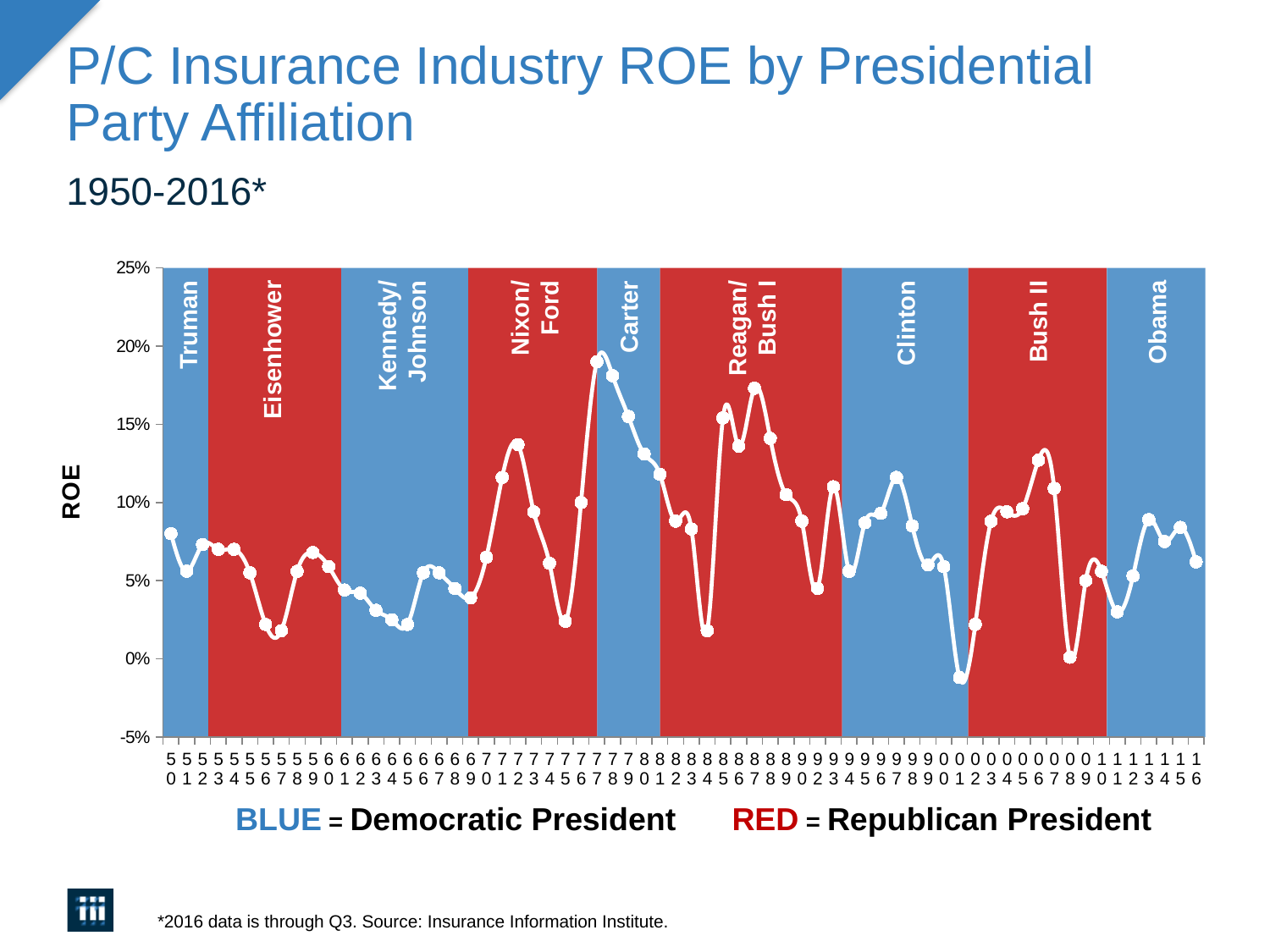
According to the legend below the chart, what does a red background represent? Republican President Does the ROE rise or fall from 1950 to 1956? fall Is the ROE value for 1950 greater or less than 5%? greater Is the ROE value for 1984 greater or less than 5%? less How many presidential periods are labeled across the chart? 9 Is the ROE value for 1987 greater or less than 15%? greater Does the ROE rise or fall from 1984 to 1987? rise What is the label on the y-axis of the chart? ROE What kind of chart is shown on the slide? line chart